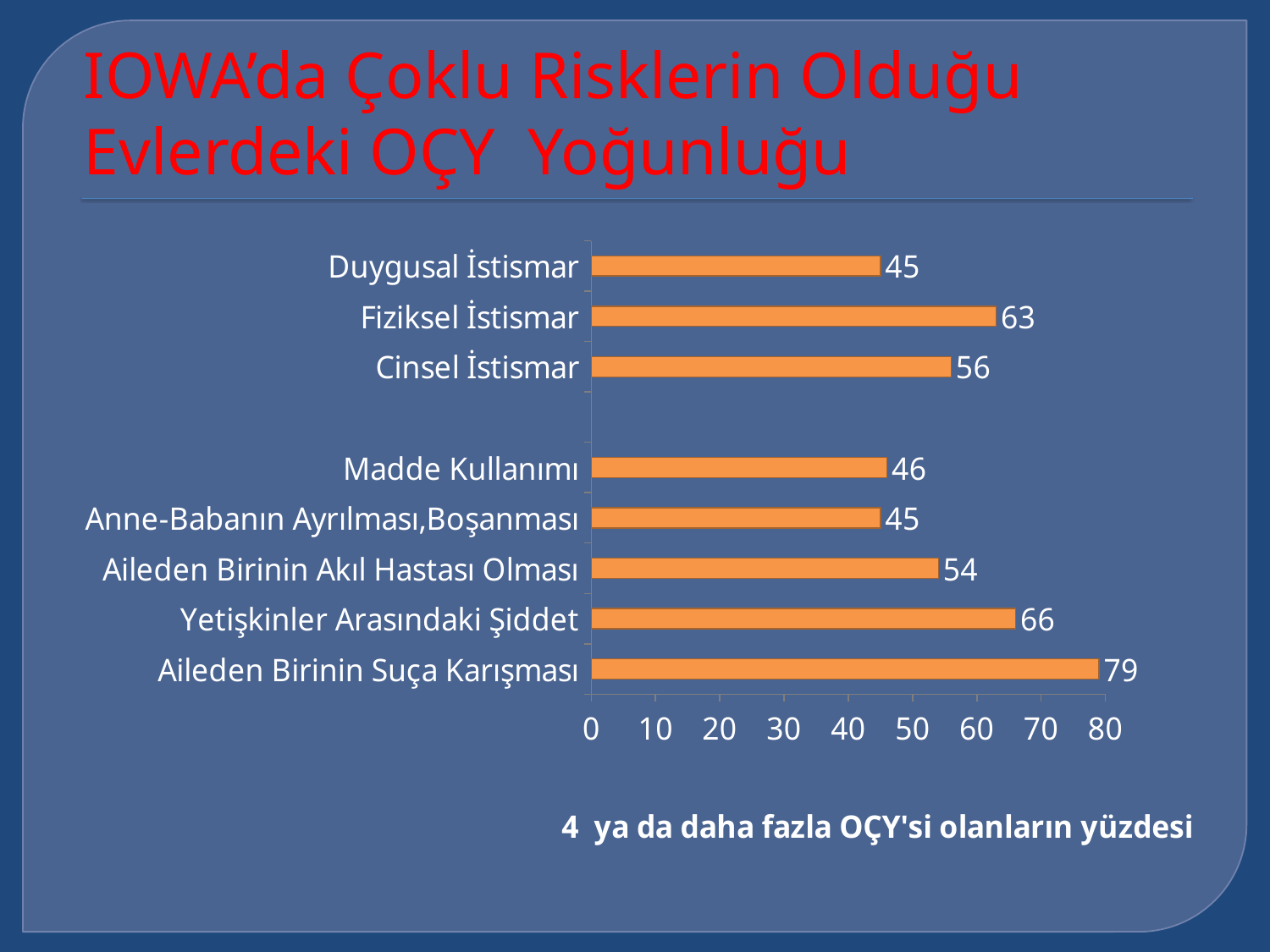
What is the value for Aileden Birinin Suça Karışması? 79 What is the highest value shown on the x axis? 80 What is the difference between the values for Aileden Birinin Suça Karışması and Yetişkinler Arasındaki Şiddet? 13 What kind of chart is shown on the slide? bar chart Which category has the highest value? Aileden Birinin Suça Karışması What is the value for Duygusal İstismar? 45 What is the value for Madde Kullanımı? 46 Is the value for Yetişkinler Arasındaki Şiddet greater or less than 60? greater Which is larger, the value for Cinsel İstismar or the value for Ailedeki Birinin Akıl Hastası Olması? Cinsel İstismar What is the difference between the values for Fiziksel İstismar and Cinsel İstismar? 7 What is the value for Fiziksel İstismar? 63 How many categories have bars in the chart? 8